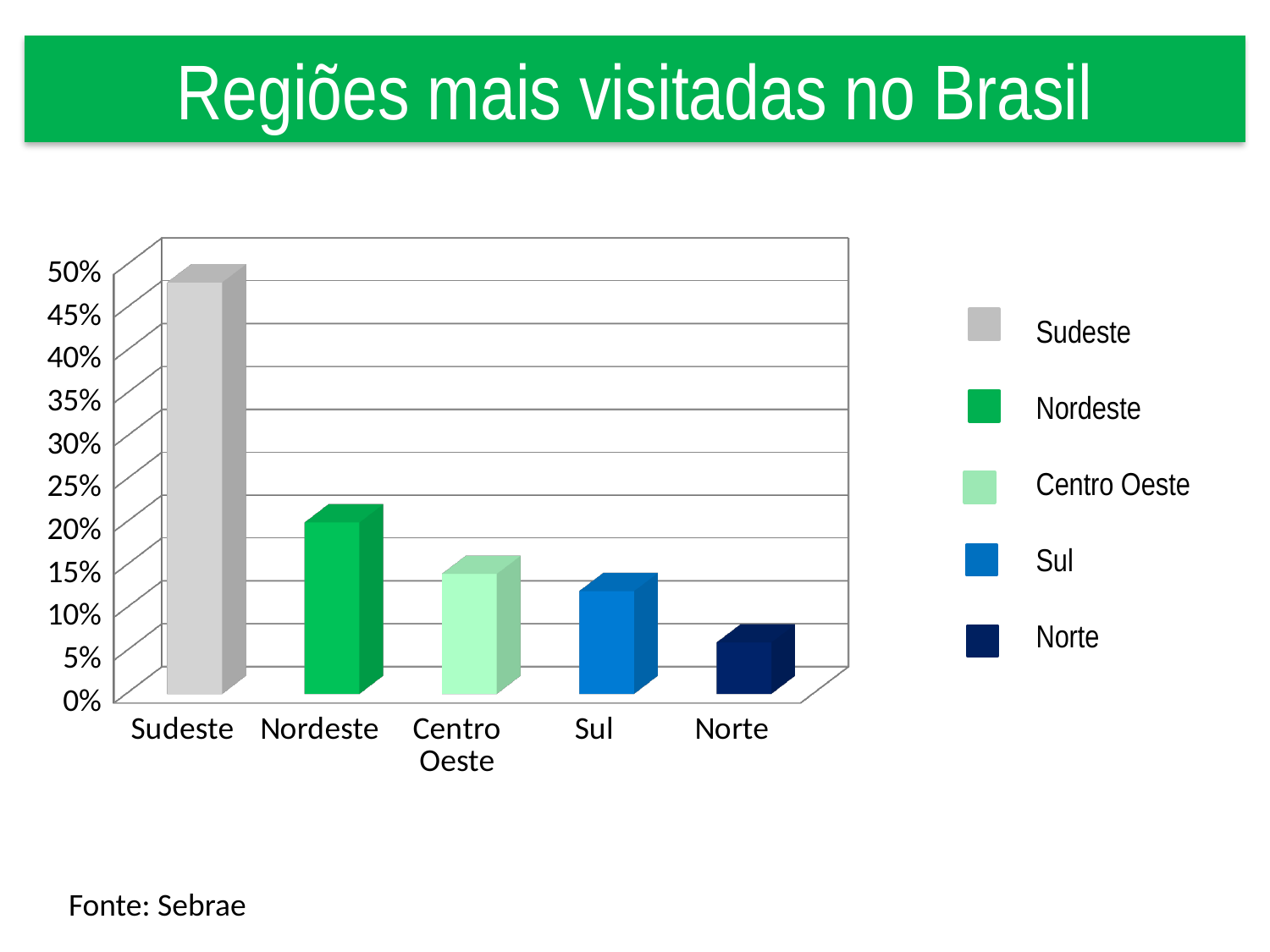
Is the value for Centro Oeste greater or less than 20%? less How many regions are shown on the x axis of the chart? 5 How many entries does the legend list? 5 Is the value for Norte greater or less than 10%? less Is the value for Nordeste greater or less than 25%? less What is the title of the chart on the slide? Regiões mais visitadas no Brasil What kind of chart is shown on the slide? bar chart Do the values rise or fall from left to right along the x axis? fall Which region has the lowest value in the chart? Norte Which region has the highest value in the chart? Sudeste Which has a larger value, Nordeste or Sul? Nordeste